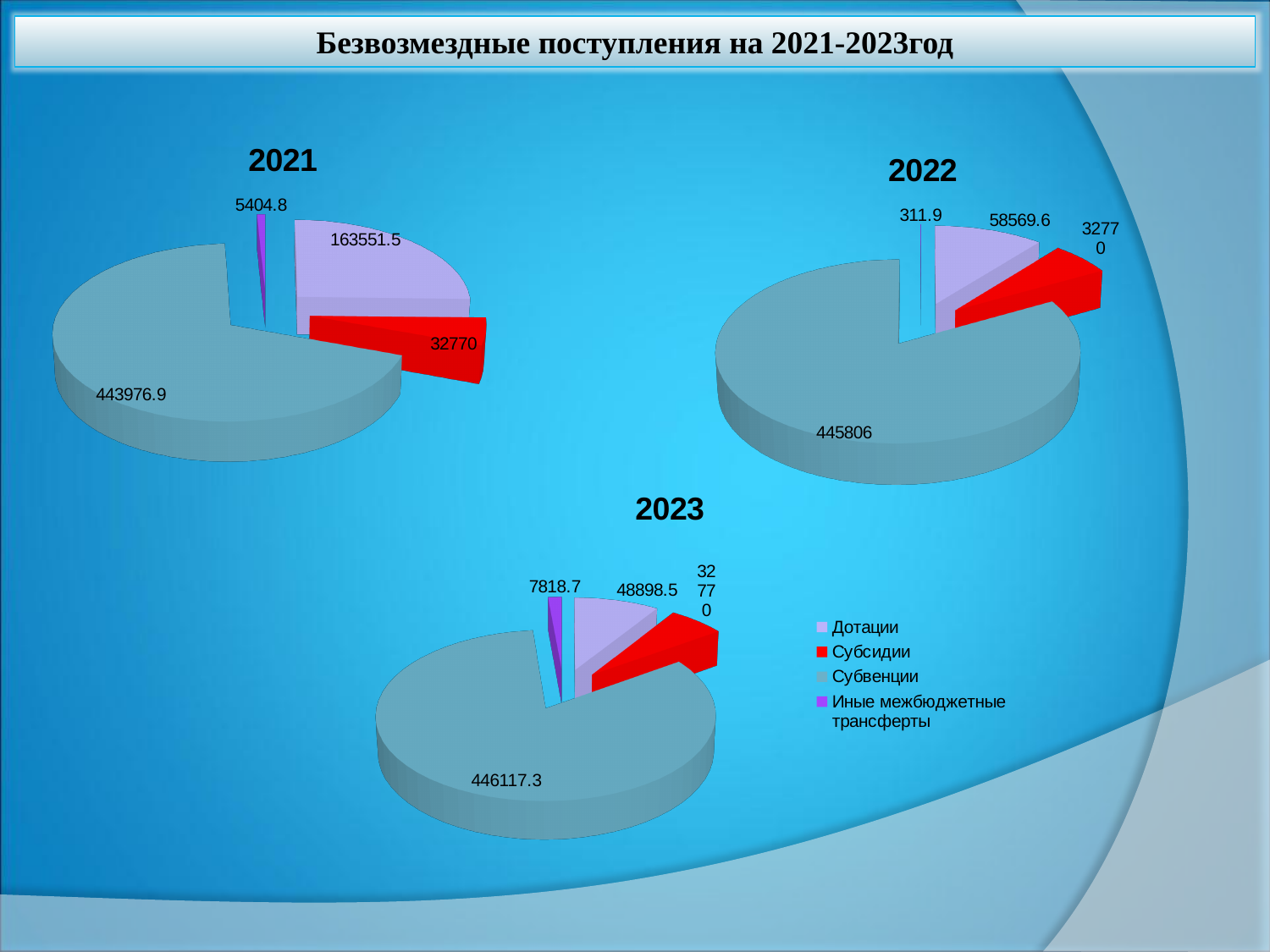
What kind of chart is used for the 2022 data? Pie chart In the 2022 pie chart, which category has the smallest value? Иные межбюджетные трансферты In the 2021 pie chart, what is the value for Дотации? 163551.5 In the 2023 pie chart, which category has the largest value? Субвенции What colour represents Субсидии in the legend? Red In the 2021 pie chart, what is the difference between the values for Дотации and Субсидии? 130781.5 In the 2022 pie chart, what is the value for Иные межбюджетные трансферты? 311.9 In the 2022 pie chart, what is the difference between the values for Дотации and Субсидии? 25799.6 In the 2023 pie chart, what is the value for Дотации? 48898.5 How many categories does the legend list? 4 In the 2023 pie chart, which is larger, the value for Субсидии or the value for Иные межбюджетные трансферты? Субсидии In the 2021 pie chart, what is the value for Субвенции? 443976.9